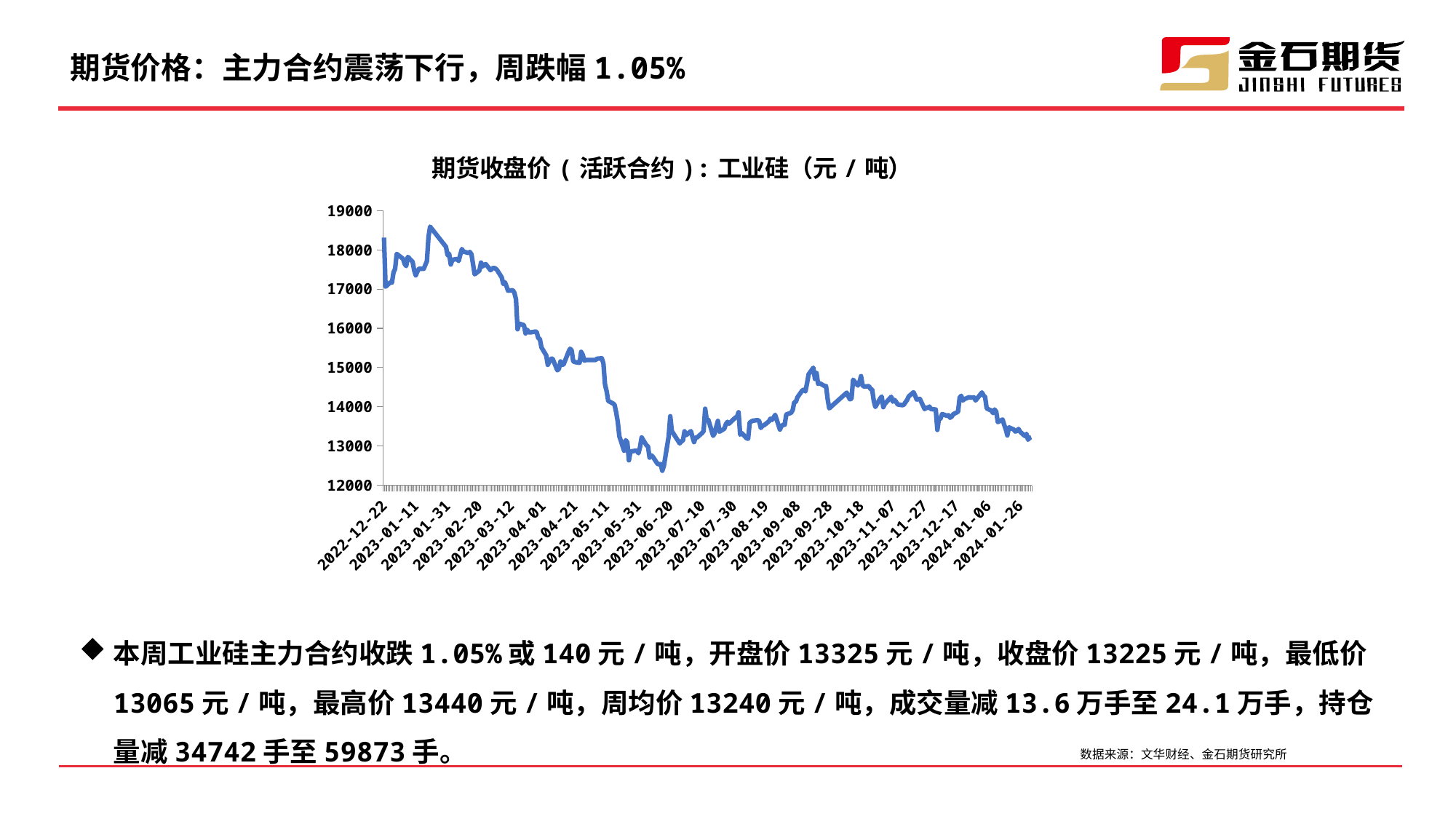
How many date labels are shown on the x axis? 21 Overall, does the line rise or fall from the start of the x axis (2022-12-22) to the end (2024-01-26)? fall In which month does the line reach its highest point? January 2023 In which month does the line reach its lowest point? June 2023 Is the value at the end of the series (2024-01-26) greater or less than 14000? less What is the title of the chart? 期货收盘价（活跃合约）：工业硅（元/吨） Is the value around 2023-06-20 greater or less than 14000? less What kind of chart is shown on the slide? line chart Is the value around 2023-04-01 greater or less than 16000? less What are the lowest and highest values shown on the y axis? 12000 and 19000